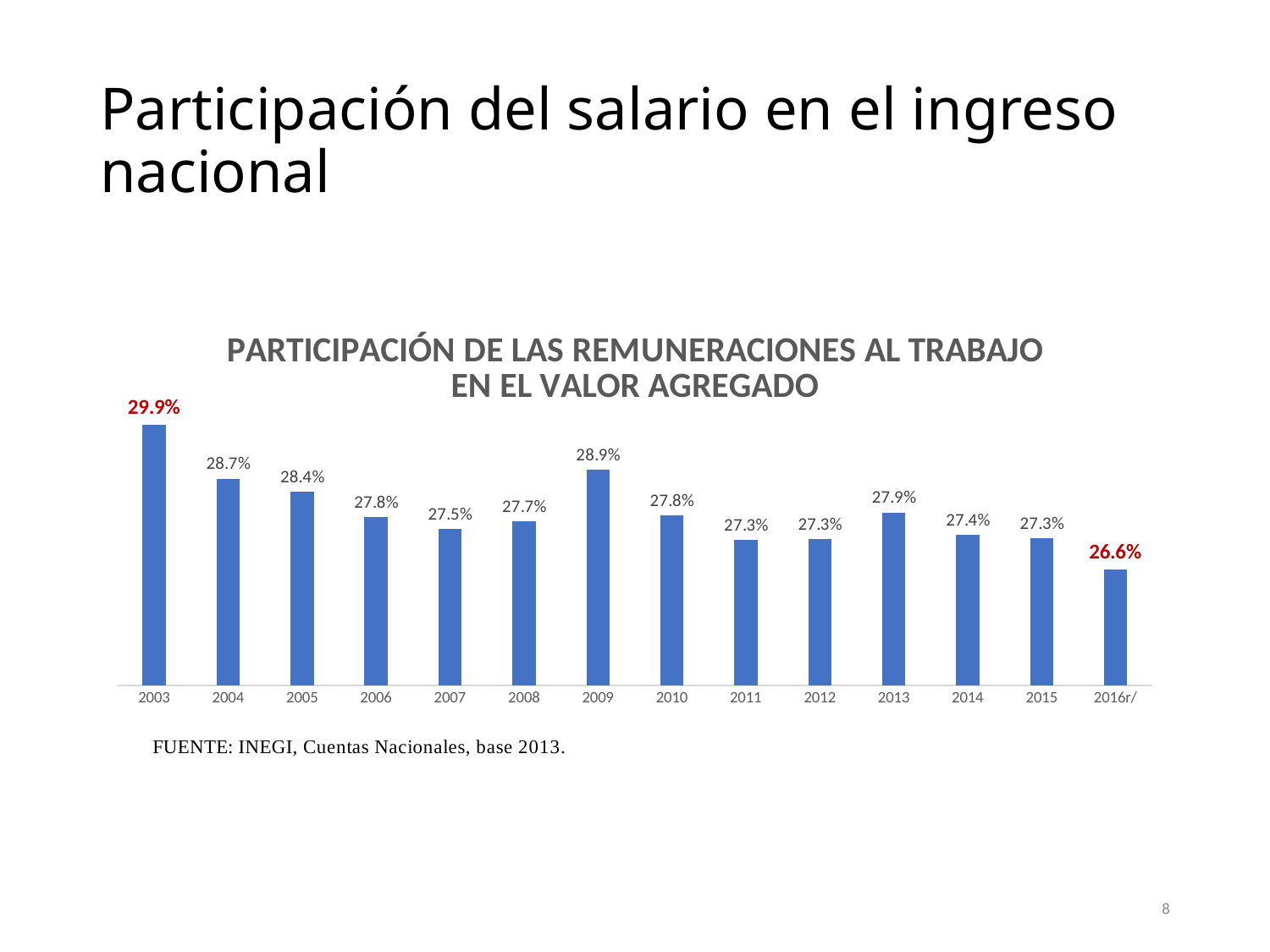
What kind of chart is shown? Bar chart What is the value for 2003? 29.9% How many years are shown on the x axis? 14 What is the title of the chart? PARTICIPACIÓN DE LAS REMUNERACIONES AL TRABAJO EN EL VALOR AGREGADO Which is larger, the value for 2005 or the value for 2014? 2005 What is the difference between the values for 2009 and 2010? 1.1% What is the value for 2009? 28.9% What is the value for 2016r/? 26.6% What is the difference between the values for 2003 and 2016r/? 3.3% Which year has the highest value? 2003 What is the value for 2013? 27.9% Which year has the lowest value? 2016r/